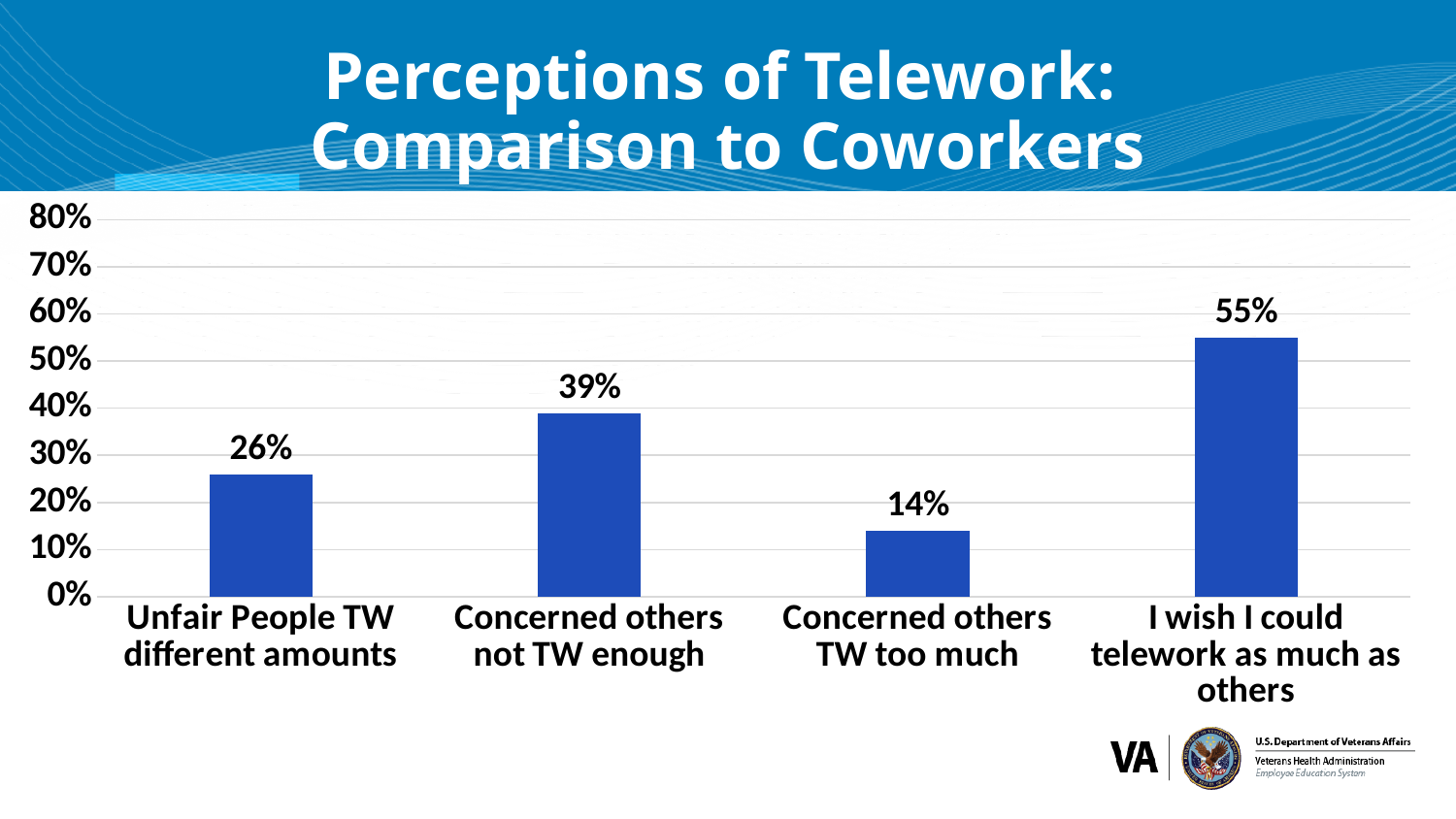
What is the value for "Concerned others not TW enough"? 39% How many categories are shown in the chart? 4 Which category has the highest value? I wish I could telework as much as others What is the difference between "Concerned others not TW enough" and "Unfair People TW different amounts"? 13% What is the value for "Concerned others TW too much"? 14% What is the value for "I wish I could telework as much as others"? 55% Which category has the lowest value? Concerned others TW too much What is the value for "Unfair People TW different amounts"? 26% What is the difference between "I wish I could telework as much as others" and "Concerned others TW too much"? 41% What kind of chart is shown on the slide? Bar chart Which is larger: "Concerned others not TW enough" or "Unfair People TW different amounts"? Concerned others not TW enough What is the title of the chart? Perceptions of Telework: Comparison to Coworkers